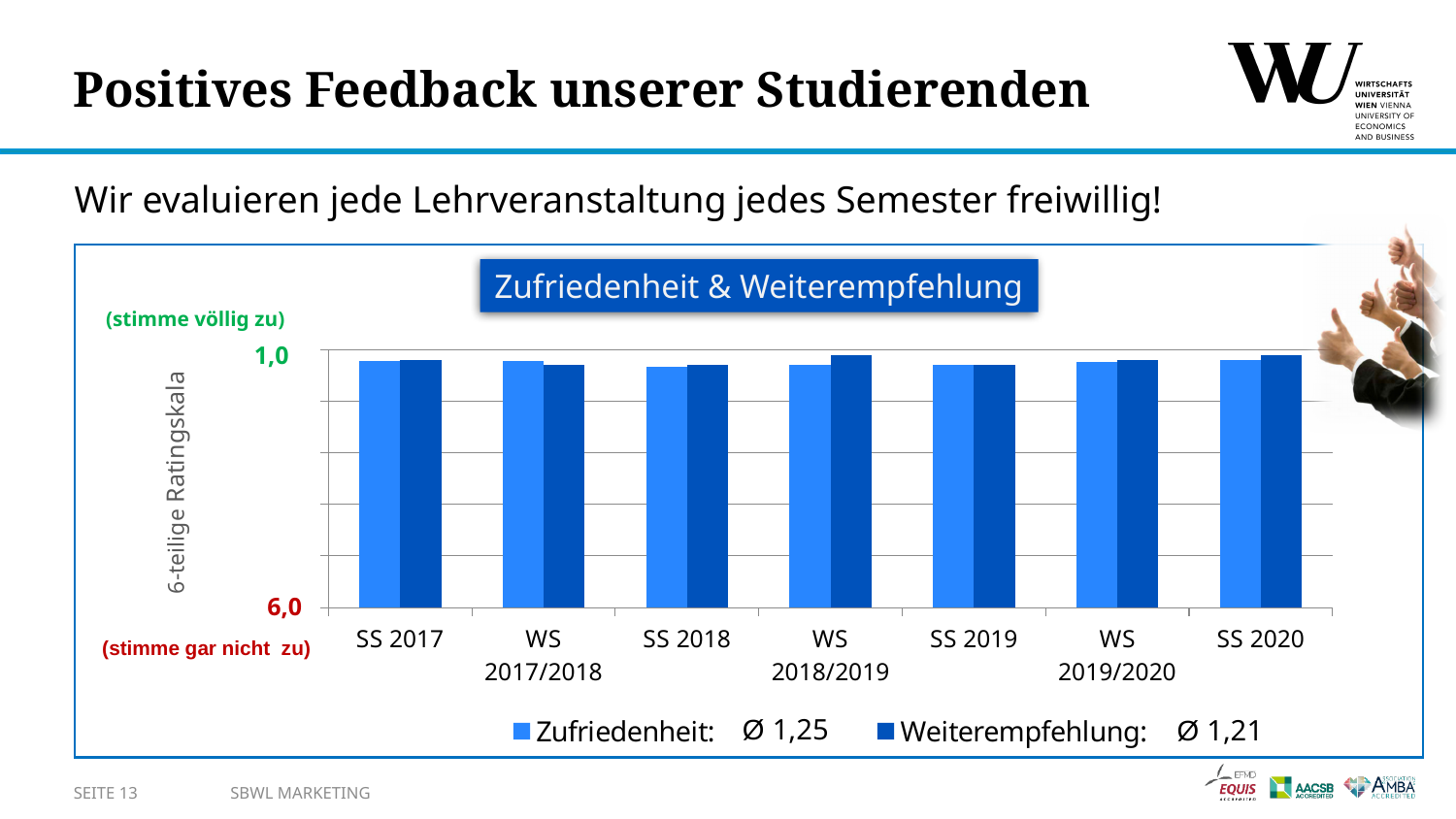
How many semesters (categories) are shown on the x axis of the chart? 7 What is the difference between the two average values shown in the legend (Ø 1,25 and Ø 1,21)? 0,04 What average value (Ø) is given in the legend for Zufriedenheit? Ø 1,25 Which series has the lower (better) average value shown in the legend, Zufriedenheit or Weiterempfehlung? Weiterempfehlung Is the value for Zufriedenheit in SS 2017 greater or less than 6,0? less How many series does the chart's legend list? 2 What is the title of the chart? Zufriedenheit & Weiterempfehlung What is the last category on the x axis of the chart? SS 2020 What kind of chart is shown on the slide? bar chart What is the first category on the x axis of the chart? SS 2017 What is the label of the vertical axis of the chart? 6-teilige Ratingskala What average value (Ø) is given in the legend for Weiterempfehlung? Ø 1,21